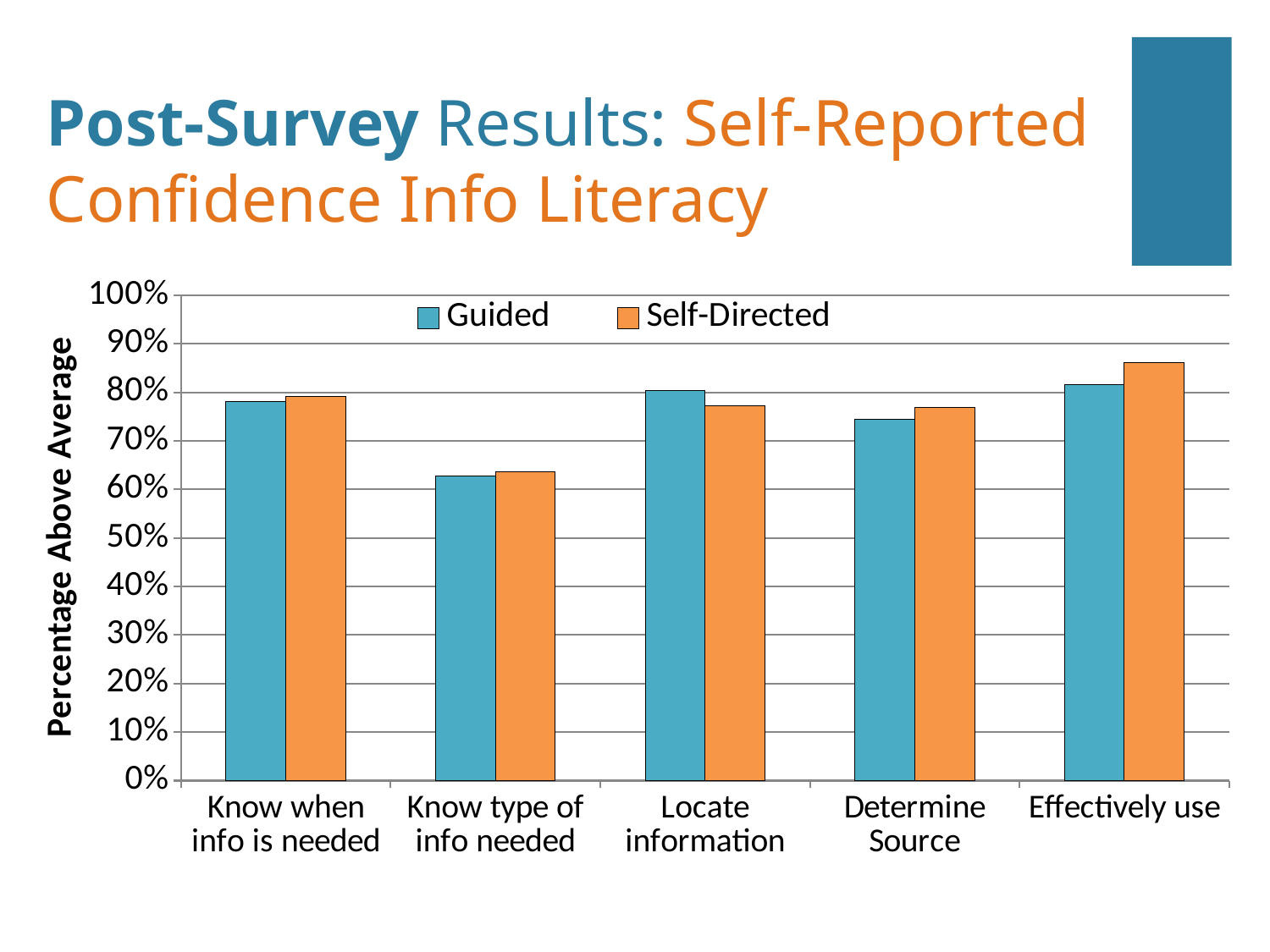
How many series does the legend list? 2 Is the Guided value for Know type of info needed greater or less than 70%? less What kind of chart is shown on the slide? bar chart Is the Self-Directed value for Effectively use greater or less than 80%? greater Which category has the lowest Guided value? Know type of info needed For Effectively use, which is larger: Guided or Self-Directed? Self-Directed What is the label on the y axis? Percentage Above Average For Locate information, which is larger: Guided or Self-Directed? Guided Which category has the highest Self-Directed value? Effectively use Which category has the lowest Self-Directed value? Know type of info needed How many categories are shown on the x axis? 5 Is the Guided value for Determine Source greater or less than 80%? less